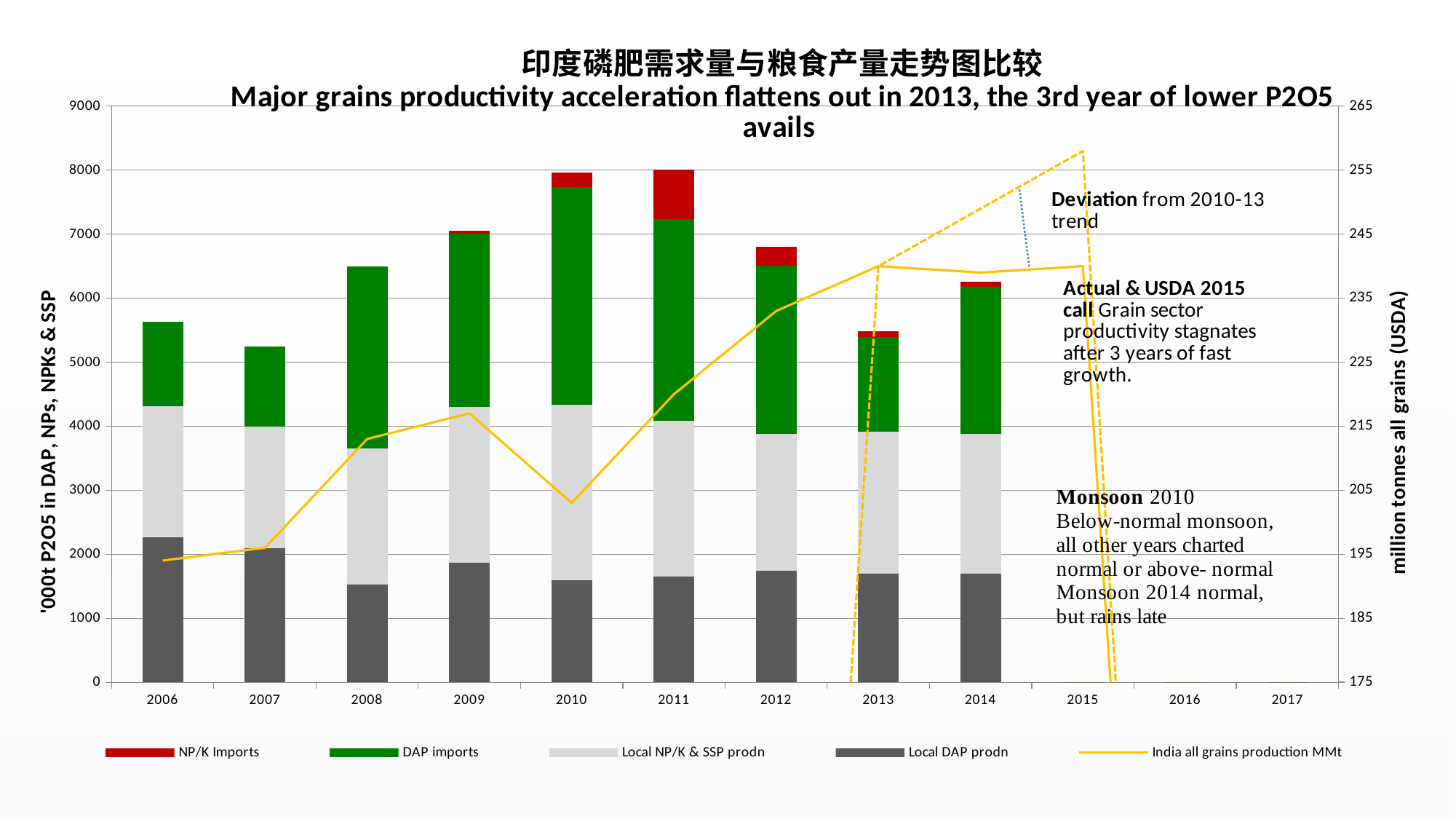
Does the India all grains production line rise or fall from 2010 to 2013? rise What kind of chart is shown on the slide? A stacked bar chart combined with a line chart Is the Local DAP prodn value for 2008 greater or less than 2000? less Is the total stacked bar value for 2013 greater or less than 6000? less Which year has the lowest total stacked bar? 2007 For how many years are stacked bars plotted? 9 Is the India all grains production value for 2012 greater or less than 225 on the right axis? greater Which year has the larger total stacked bar, 2007 or 2008? 2008 Which series is shown in red in the legend? NP/K Imports How many series does the legend list? 5 In which year is the India all grains production line at its lowest? 2006